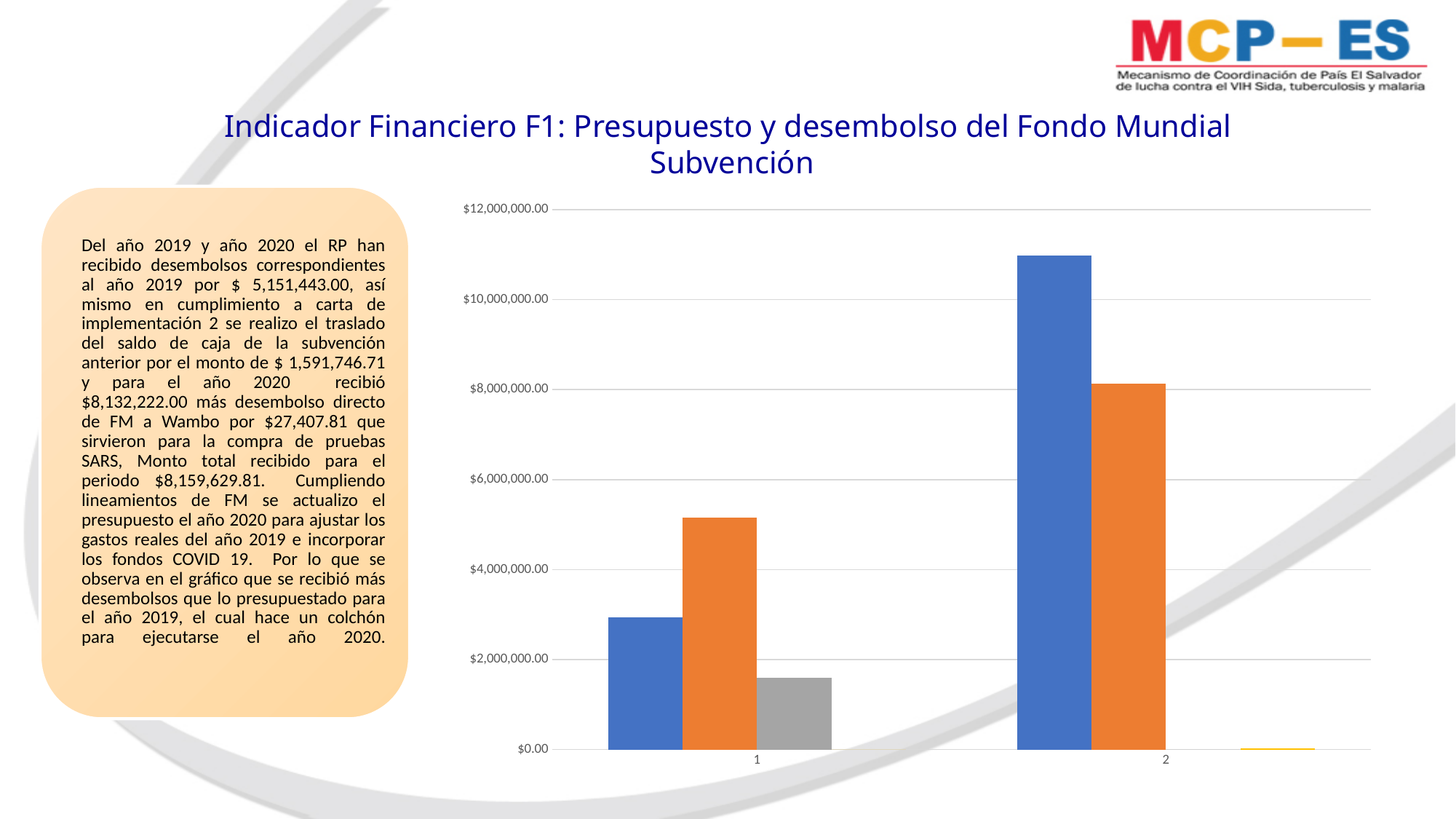
In category 1, is the orange bar greater or less than $4,000,000.00? greater In category 2, is the orange bar greater or less than $10,000,000.00? less How many bars are shown for category 1? 3 What kind of chart is shown on the slide? bar chart Which bar is the tallest in the whole chart? the blue bar in category 2 In category 1, is the gray bar greater or less than $2,000,000.00? less In category 1, which bar is taller, the blue bar or the orange bar? the orange bar How many categories are shown on the x axis of the chart? 2 In category 2, which bar is taller, the blue bar or the orange bar? the blue bar Does the blue series rise or fall from category 1 to category 2? rise